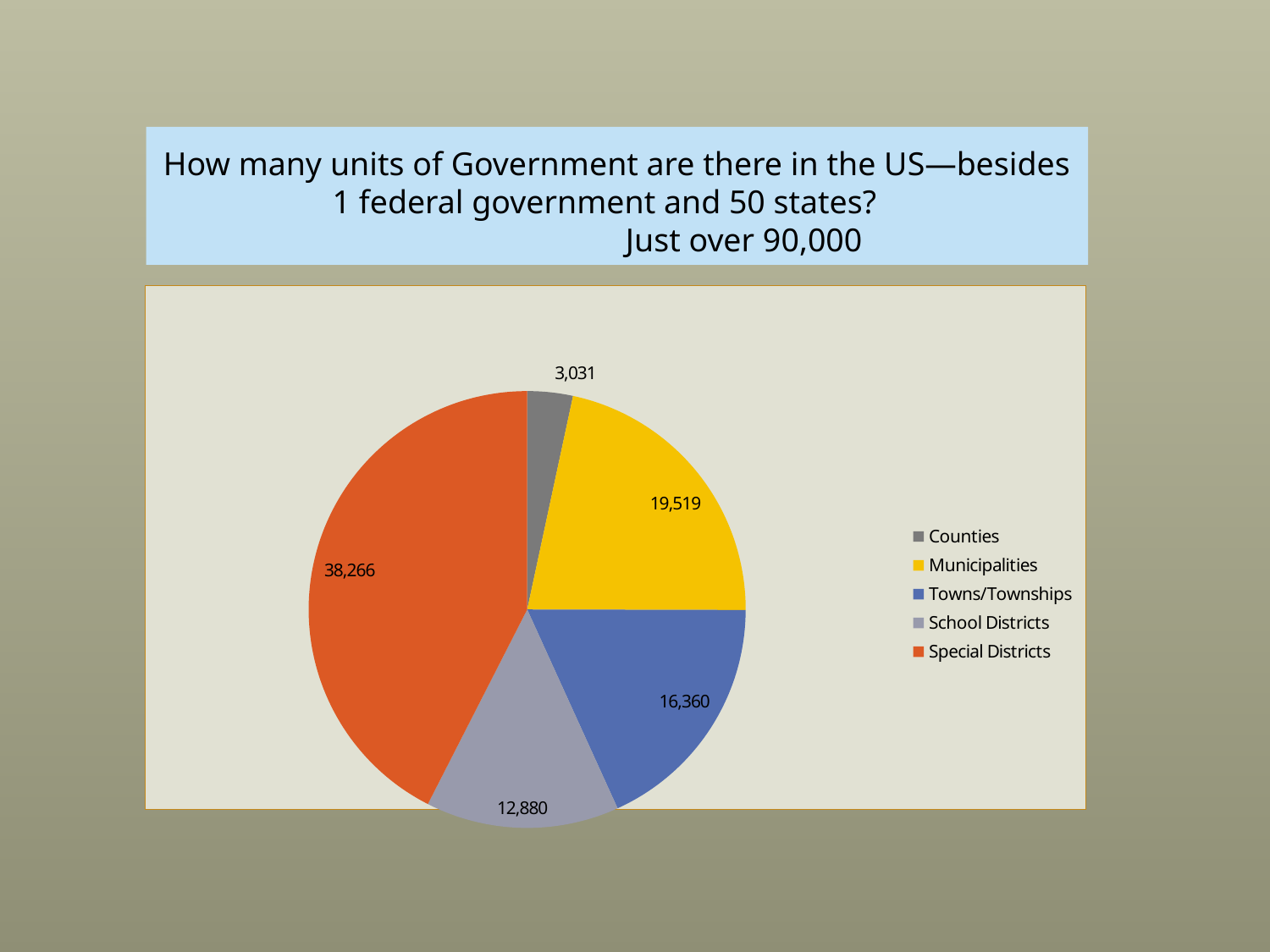
Which category has the largest slice of the pie chart? Special Districts What is the value shown for Municipalities in the pie chart? 19,519 What value does the pie chart give for Towns/Townships? 16,360 How much larger is the Towns/Townships value than the School Districts value? 3,480 How many categories does the pie chart show? 5 How many Special Districts does the pie chart show? 38,266 Which category has the smallest slice of the pie chart? Counties What is the total of all the values shown in the pie chart? 90,056 What is the difference between the Special Districts value and the Municipalities value? 18,747 How many School Districts are shown in the pie chart? 12,880 What type of chart is shown on the slide? Pie chart Which is larger, Municipalities or Towns/Townships? Municipalities